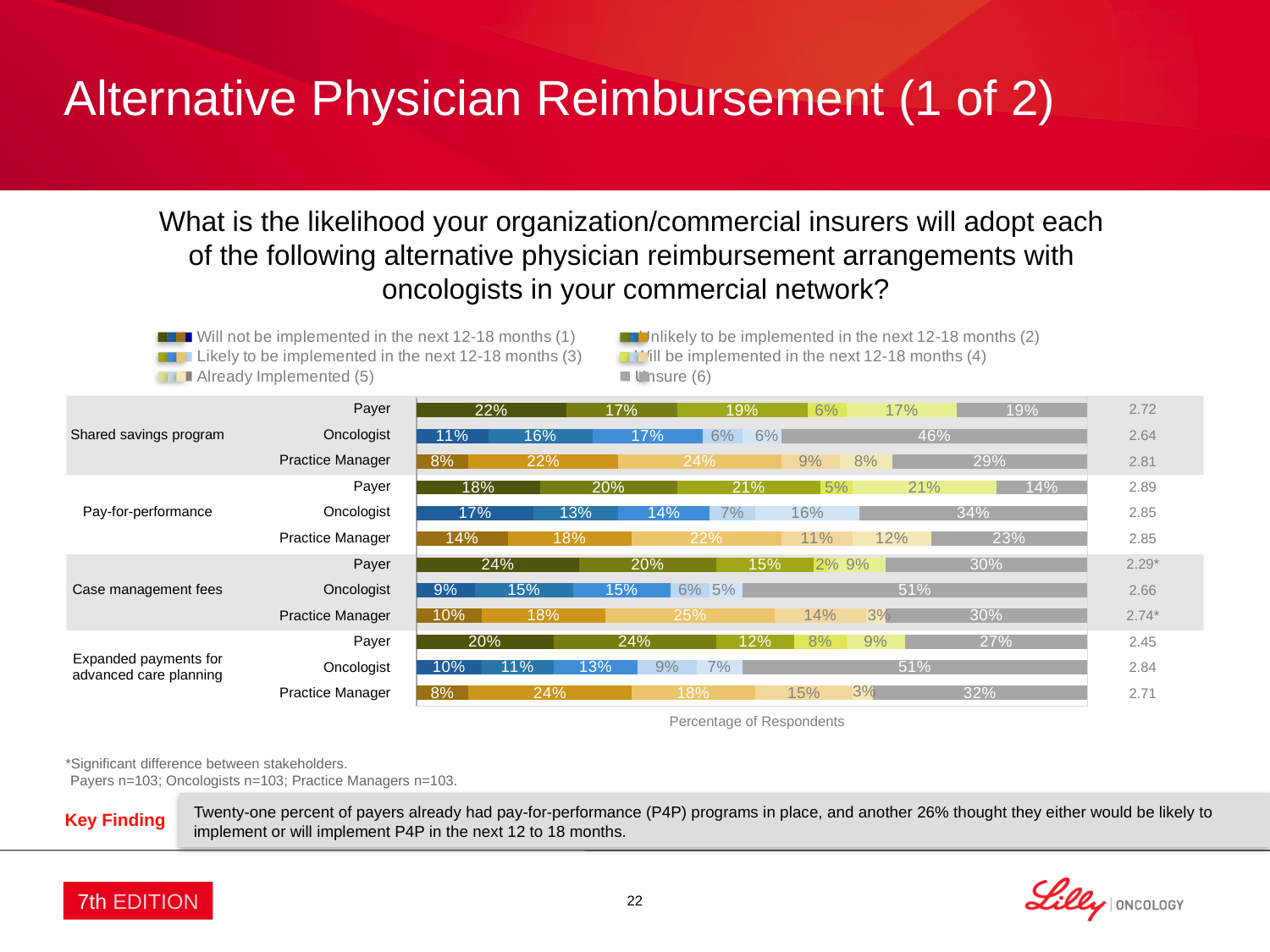
For shared savings program, which group has the larger unsure share: oncologists or practice managers? Oncologists What percentage of payers had already implemented pay-for-performance? 21% For shared savings program, what is the difference between the payer and oncologist shares saying it will not be implemented in the next 12-18 months? 11 percentage points How many stacked bars are plotted in the chart? 12 What percentage of practice managers said shared savings programs are likely to be implemented in the next 12-18 months? 24% What is the total of the stacked bar for payers on shared savings program? 100% How many series does the chart legend list? 6 What percentage of oncologists were unsure about case management fees? 51% What kind of chart is shown on the slide? Stacked bar chart What is the x-axis label of the chart? Percentage of Respondents What is the mean score shown for payers on pay-for-performance? 2.89 Among payers, which arrangement has the highest share saying it will not be implemented in the next 12-18 months? Case management fees